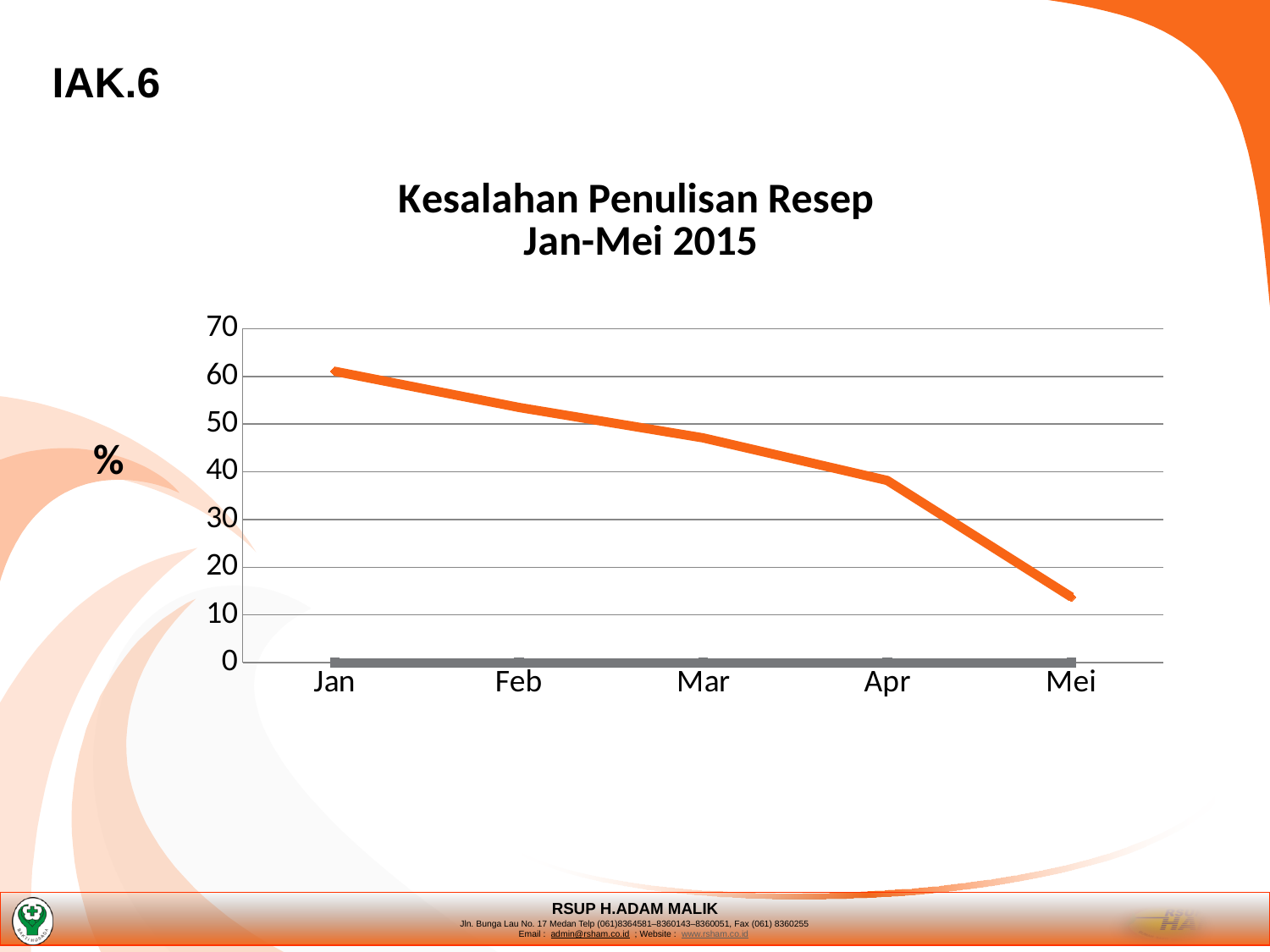
Which is larger, the value for Jan or the value for Mei? Jan Is the value for Mar greater or less than 40? greater Is the value for Jan greater or less than 50? greater Which month has the lowest value? Mei Which month has the highest value? Jan Is the value for Feb greater or less than 60? less Do the values rise or fall from Jan to Mei? fall How many months are plotted on the x axis? 5 What is the title of the chart? Kesalahan Penulisan Resep Jan-Mei 2015 What kind of chart is shown on the slide? line chart